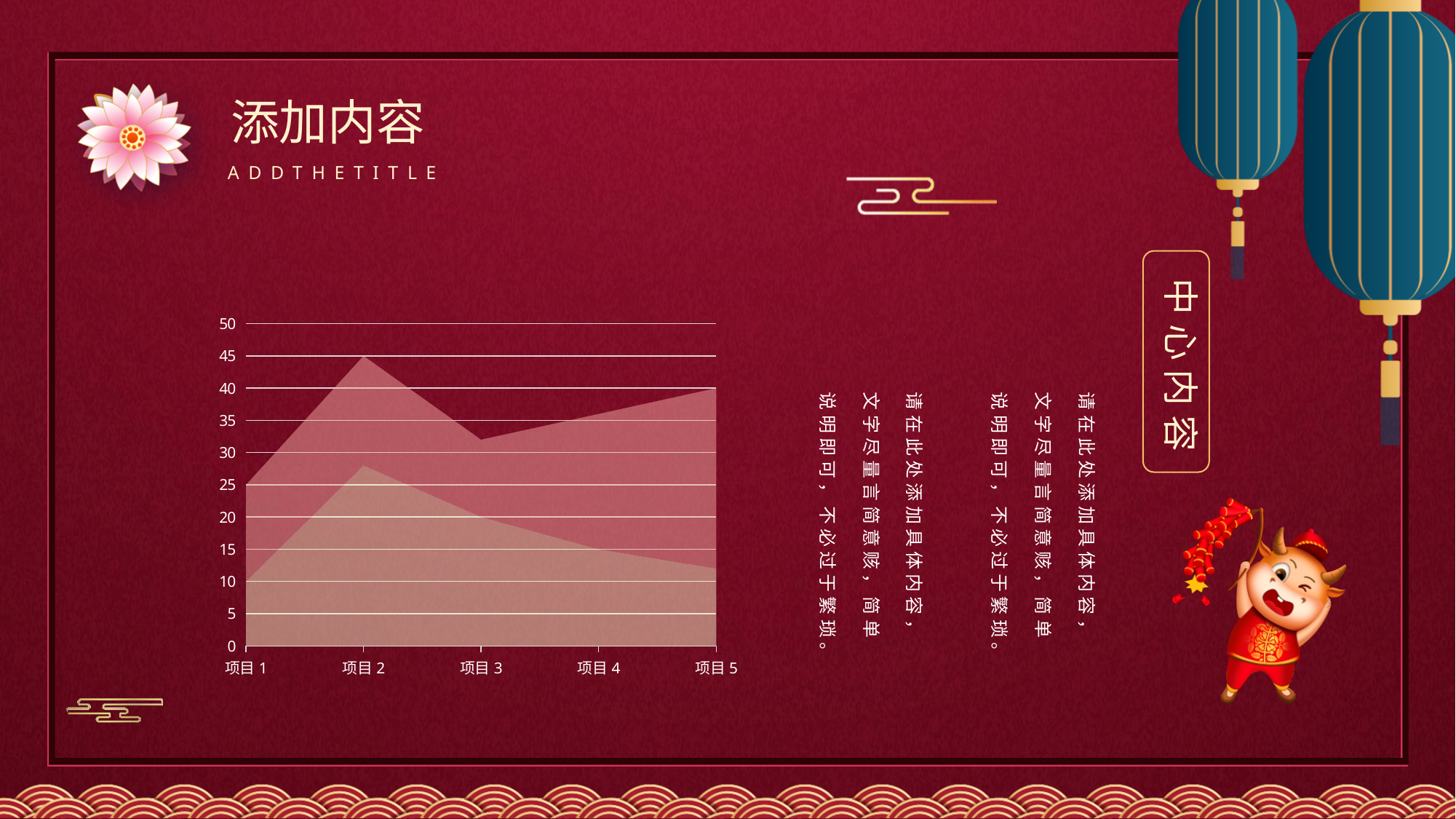
What kind of chart is shown on the slide? area chart Is the value of the lower (bottom) series at 项目 4 greater or less than 20? less Which category has the highest value for the lower (bottom) series? 项目 2 Does the upper (top) series rise or fall from 项目 3 to 项目 5? rise Is the value of the lower (bottom) series at 项目 2 greater or less than 25? greater How many categories are shown on the x axis of the chart? 5